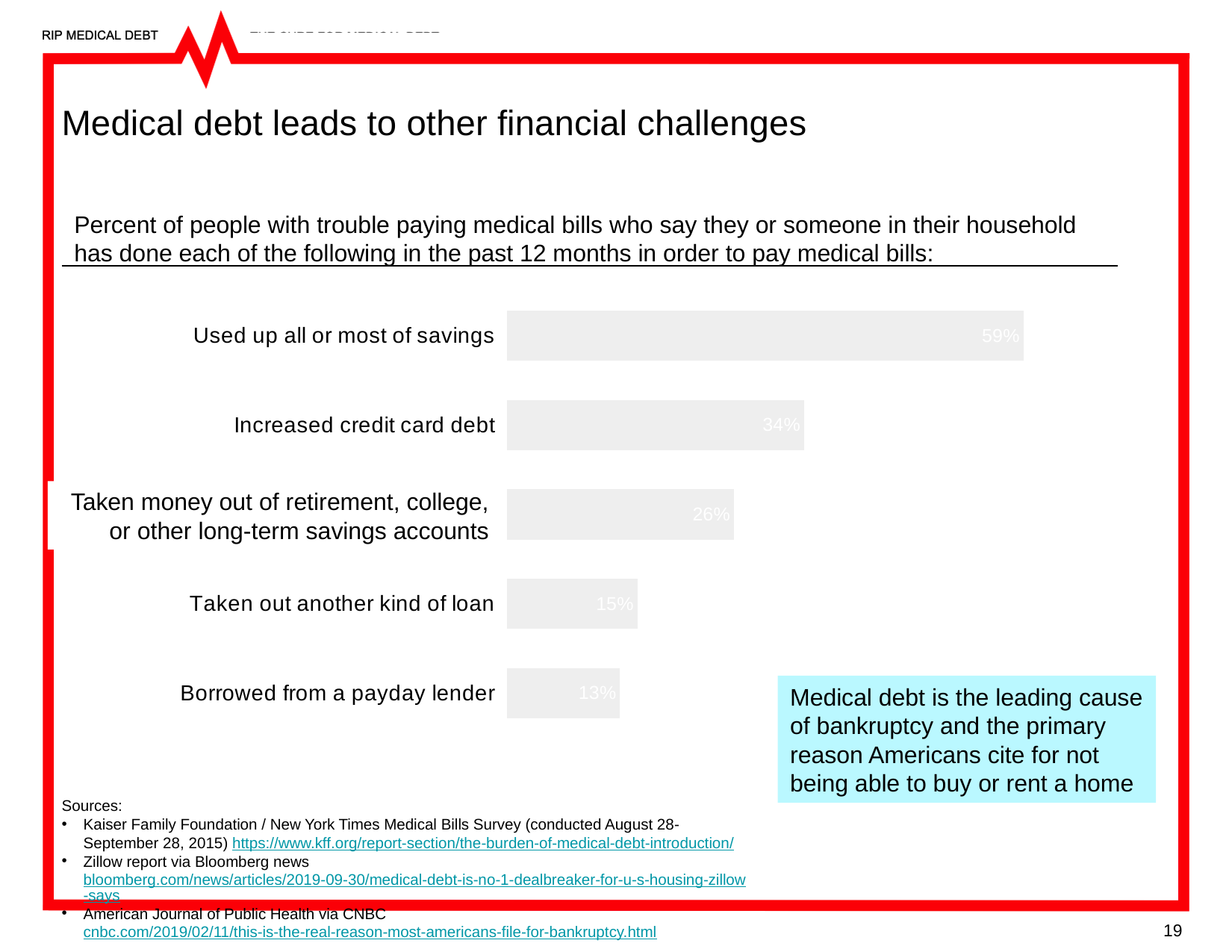
What kind of chart is shown on the slide? Bar chart What is the difference between "Taken out another kind of loan" and "Borrowed from a payday lender"? 2% Which category has the lowest value? Borrowed from a payday lender What is the value for "Increased credit card debt"? 34% What is the value for "Taken out another kind of loan"? 15% Which is larger: "Increased credit card debt" or "Taken money out of retirement, college, or other long-term savings accounts"? Increased credit card debt What is the value for "Borrowed from a payday lender"? 13% What percentage took money out of retirement, college, or other long-term savings accounts? 26% What percentage of people used up all or most of their savings to pay medical bills? 59% What is the difference between "Used up all or most of savings" and "Increased credit card debt"? 25% How many categories are shown in the chart? 5 Which category has the highest value? Used up all or most of savings